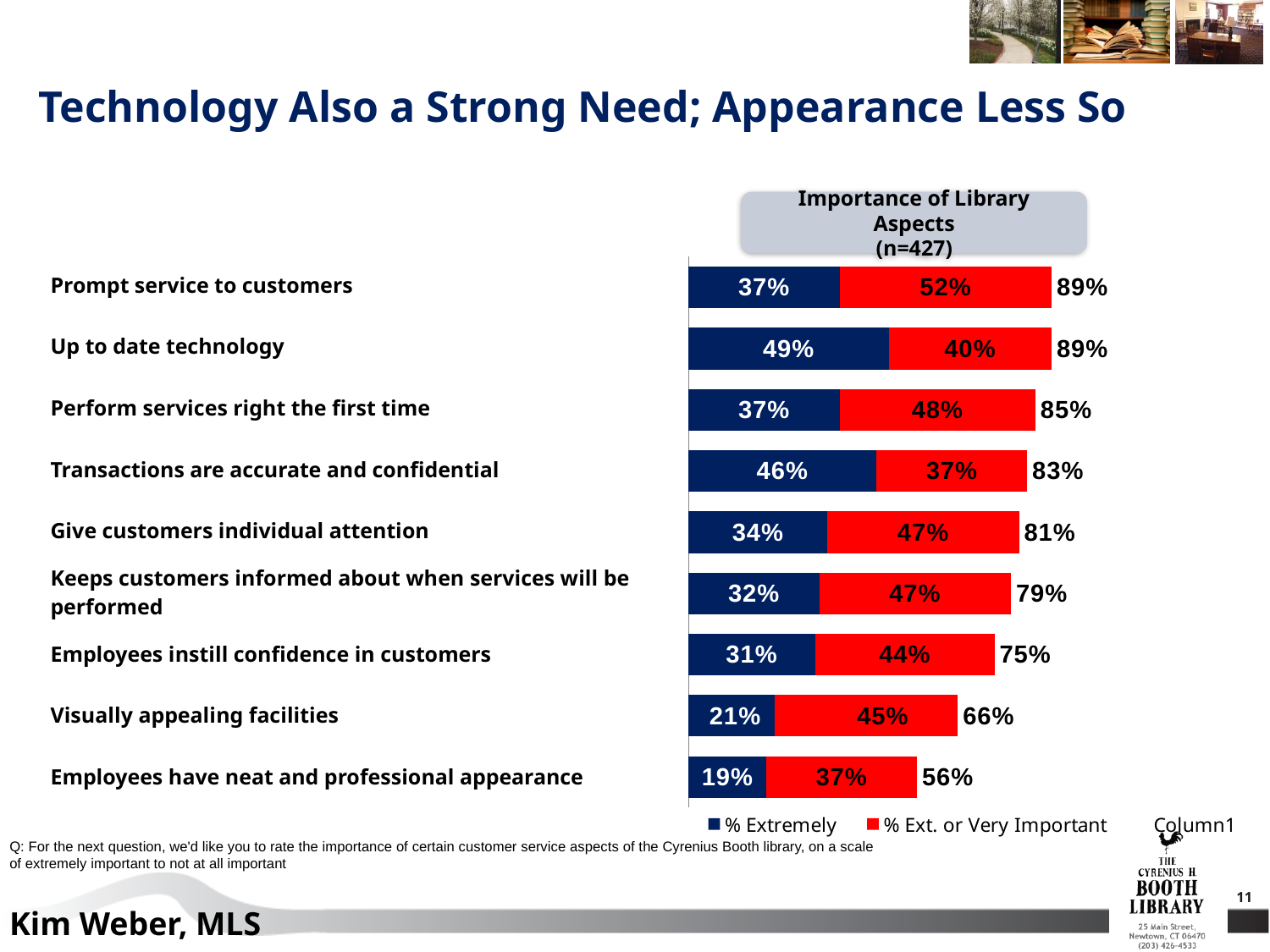
What is the difference between the % Extremely values for Transactions are accurate and confidential and Give customers individual attention? 12% What is the % Extremely value for Up to date technology? 49% What kind of chart is shown on the slide? Stacked bar chart Do the total values at the end of the bars rise or fall going from the top category to the bottom category? Fall Which category has the lowest % Extremely value? Employees have neat and professional appearance What is the % Ext. or Very Important value for Prompt service to customers? 52% What is the combined total of the two segments for Employees have neat and professional appearance? 56% What sample size (n) is given in the chart title? n=427 What is the total shown at the end of the bar for Visually appealing facilities? 66% Which category has the highest % Extremely value? Up to date technology How many library aspects (categories) are plotted in the chart? 9 Which is larger: the % Ext. or Very Important value for Perform services right the first time or for Employees instill confidence in customers? Perform services right the first time